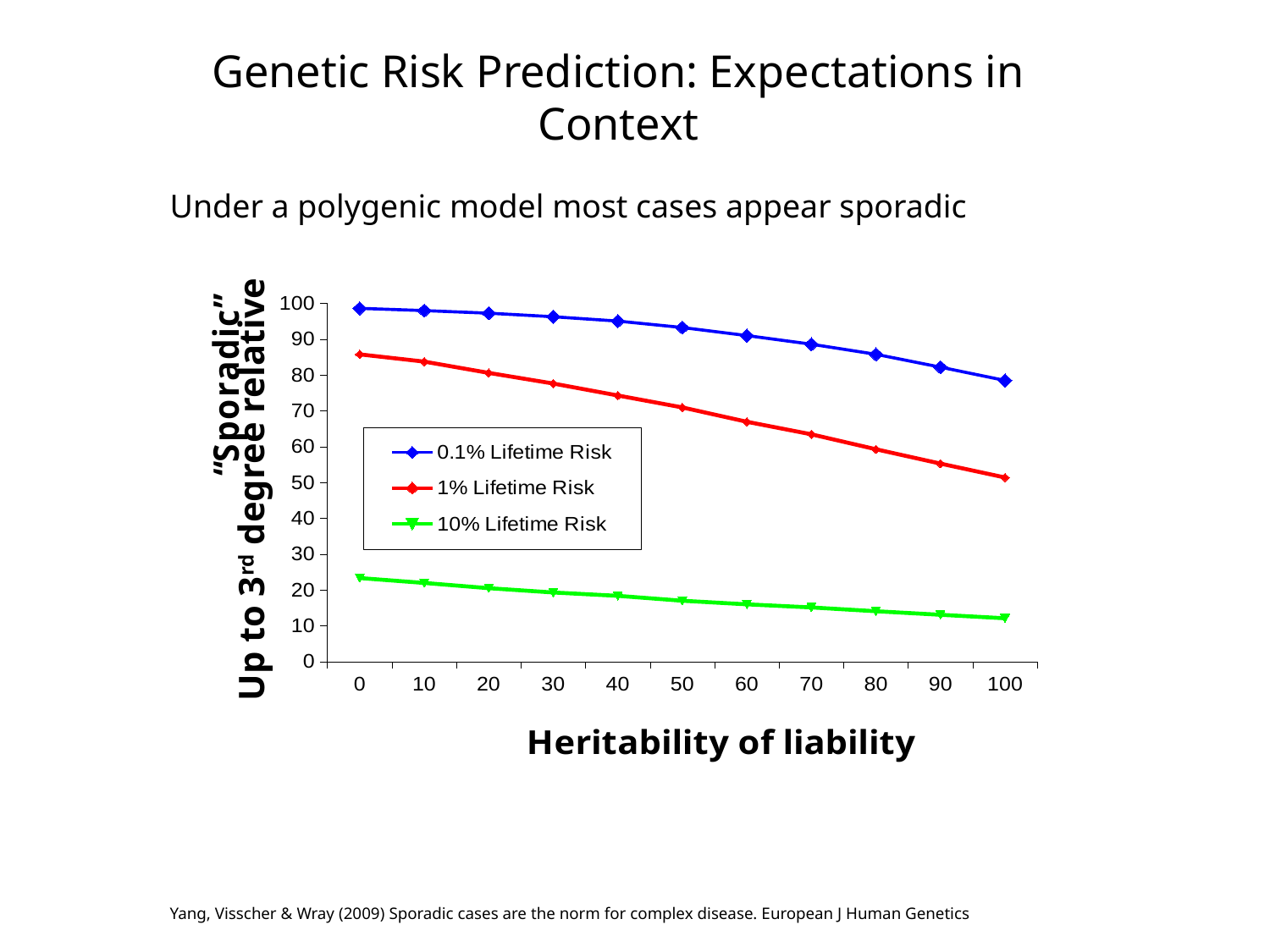
What is the title of the x axis? Heritability of liability At a heritability of liability of 50, which is larger: the value for 1% Lifetime Risk or the value for 10% Lifetime Risk? 1% Lifetime Risk Is the value for 0.1% Lifetime Risk at a heritability of liability of 0 greater or less than 90? greater How many data points are plotted for the 0.1% Lifetime Risk series? 11 What kind of chart is shown on the slide? line chart Which series has the lowest value at a heritability of liability of 100? 10% Lifetime Risk How many series does the legend list? 3 Is the value for 10% Lifetime Risk at a heritability of liability of 100 greater or less than 20? less Which series has the highest value at a heritability of liability of 0? 0.1% Lifetime Risk What colour is the line for the 10% Lifetime Risk series? green Is the value for 1% Lifetime Risk at a heritability of liability of 100 greater or less than 60? less Do the values for the 1% Lifetime Risk series rise or fall as heritability of liability increases? fall